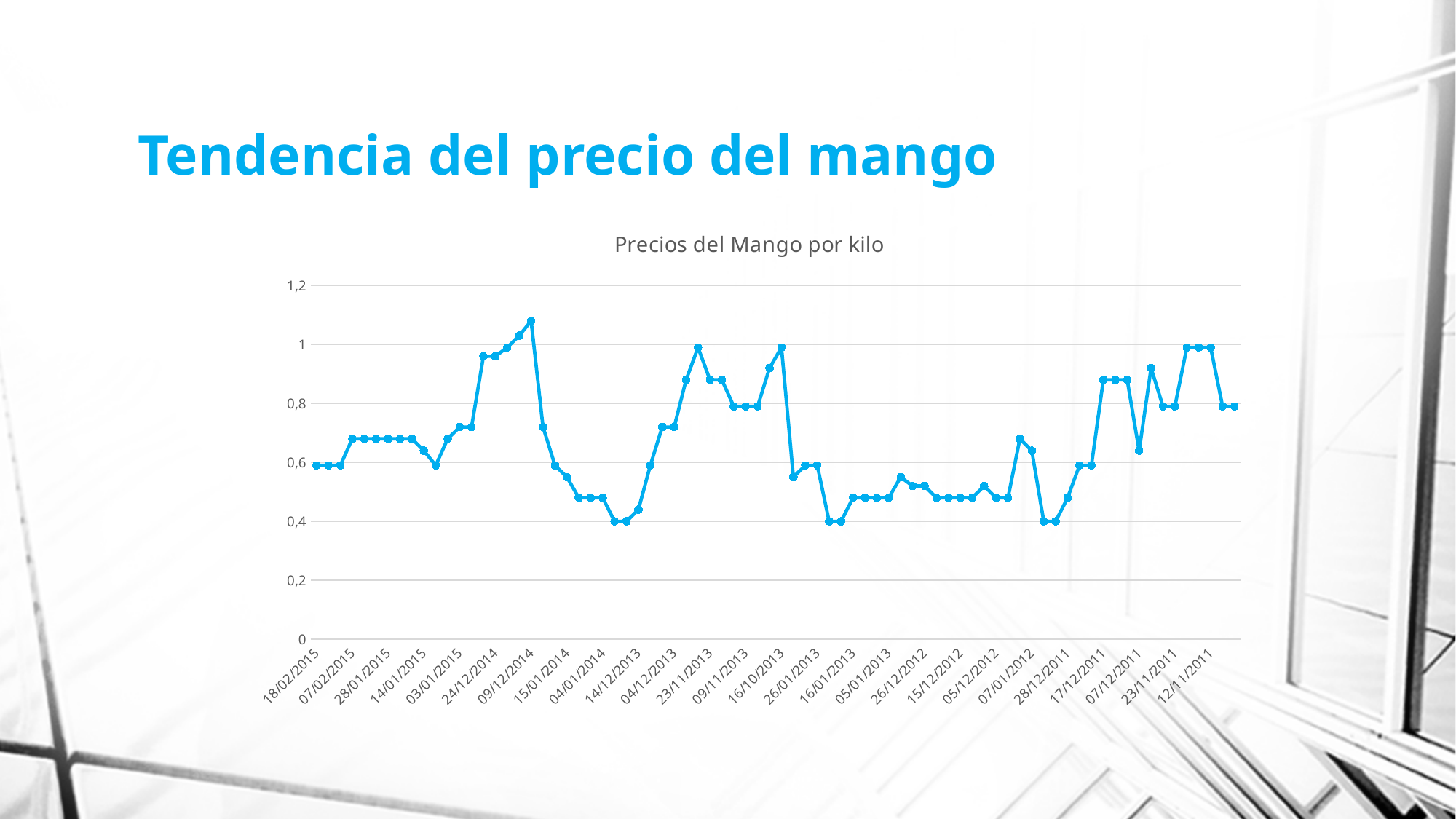
Is the value for 09/12/2014 greater or less than 1? greater What kind of chart is shown on the slide? line chart On which date does the mango price reach its highest point? 09/12/2014 Is the value for 24/12/2014 greater or less than 0,8? greater What is the title of the chart? Precios del Mango por kilo What is the highest value shown on the vertical axis? 1,2 Is the value for 07/02/2015 greater or less than 0,6? greater Which date has the larger value, 09/12/2014 or 26/01/2013? 09/12/2014